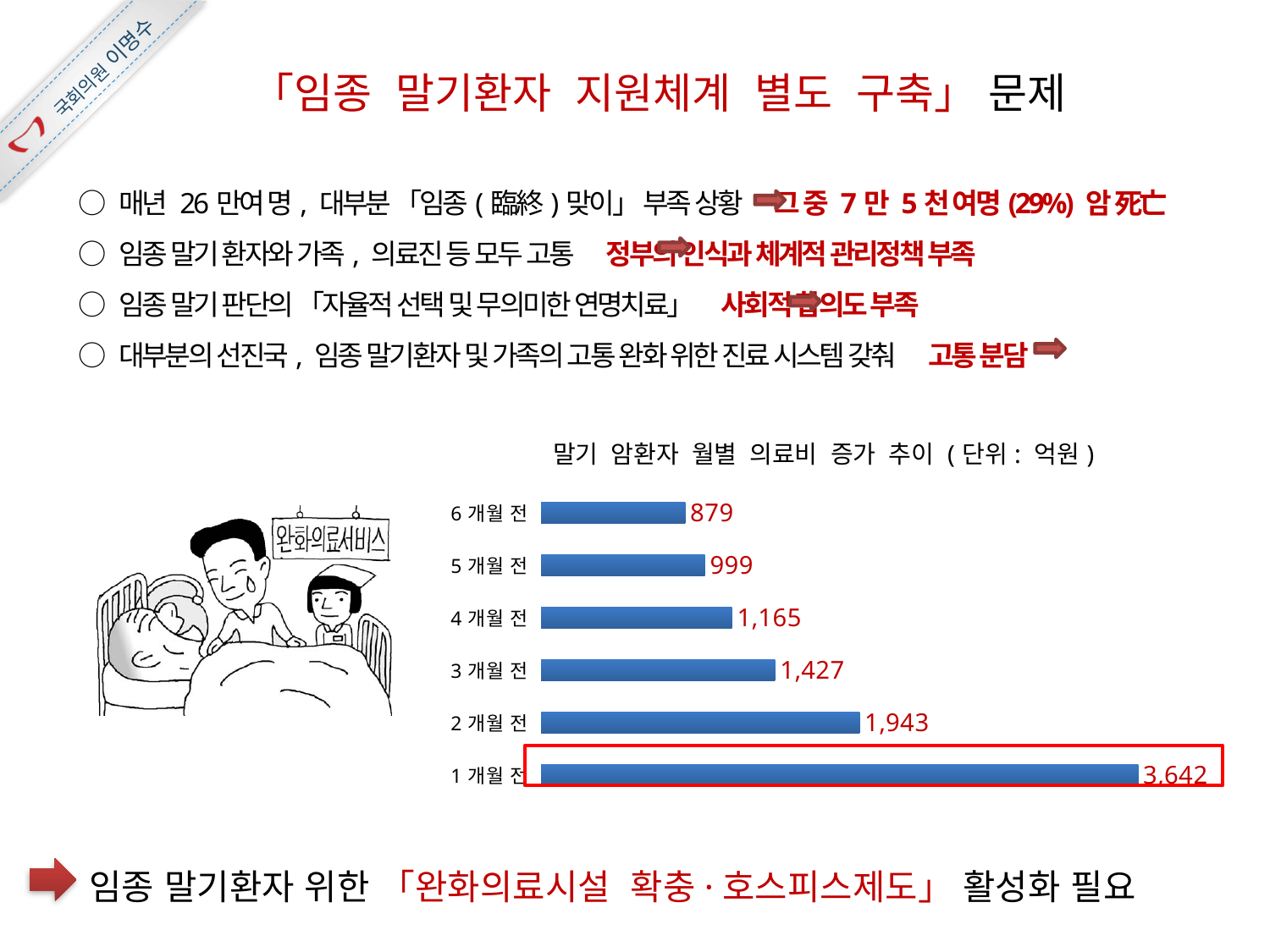
What is the value for 3 개월 전 in the chart? 1,427 Which category has the highest value in the chart? 1 개월 전 Which category has the lowest value in the chart? 6 개월 전 What is the value for 1 개월 전 in the chart? 3,642 Do the values increase or decrease going from 6 개월 전 down to 1 개월 전? Increase What kind of chart is shown on the slide? Bar chart What unit is stated in the chart title? 억원 What is the difference between the values for 1 개월 전 and 2 개월 전? 1,699 What is the value for 6 개월 전 in the chart? 879 Which is larger, the value for 4 개월 전 or the value for 2 개월 전? 2 개월 전 How many categories are shown in the chart? 6 What is the difference between the values for 5 개월 전 and 6 개월 전? 120